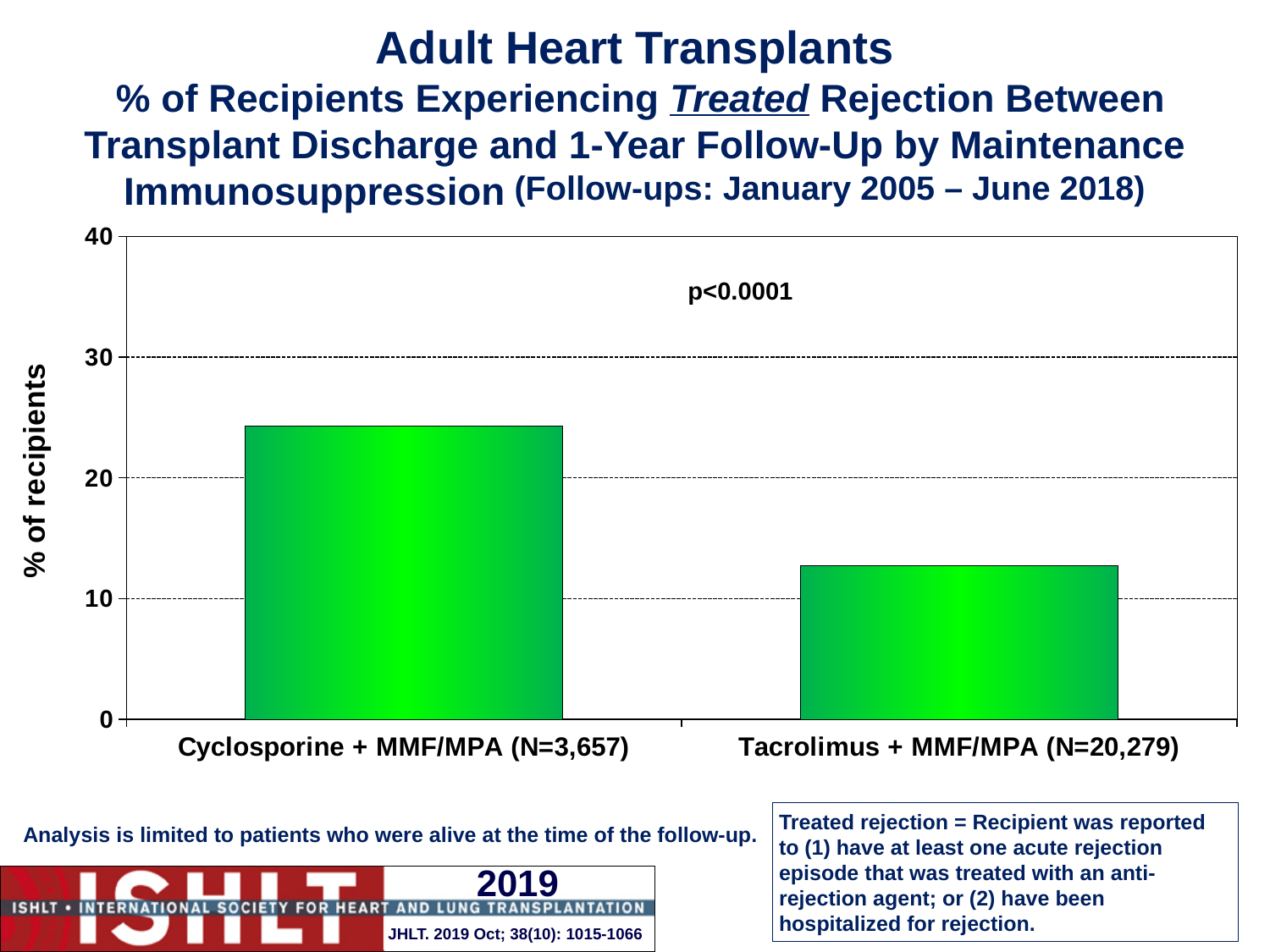
Is the value for Cyclosporine + MMF/MPA greater or less than 20? greater Is the value for Cyclosporine + MMF/MPA greater or less than 30? less Which group has a larger % of recipients with treated rejection, Cyclosporine + MMF/MPA or Tacrolimus + MMF/MPA? Cyclosporine + MMF/MPA How many categories (bars) are plotted in the chart? 2 What is the label of the y-axis of the chart? % of recipients Is the value for Tacrolimus + MMF/MPA greater or less than 10? greater What p-value is printed on the chart? p<0.0001 Which maintenance immunosuppression group has the highest % of recipients with treated rejection? Cyclosporine + MMF/MPA (N=3,657) What kind of chart is shown on the slide? bar chart Which maintenance immunosuppression group has the lowest % of recipients with treated rejection? Tacrolimus + MMF/MPA (N=20,279)